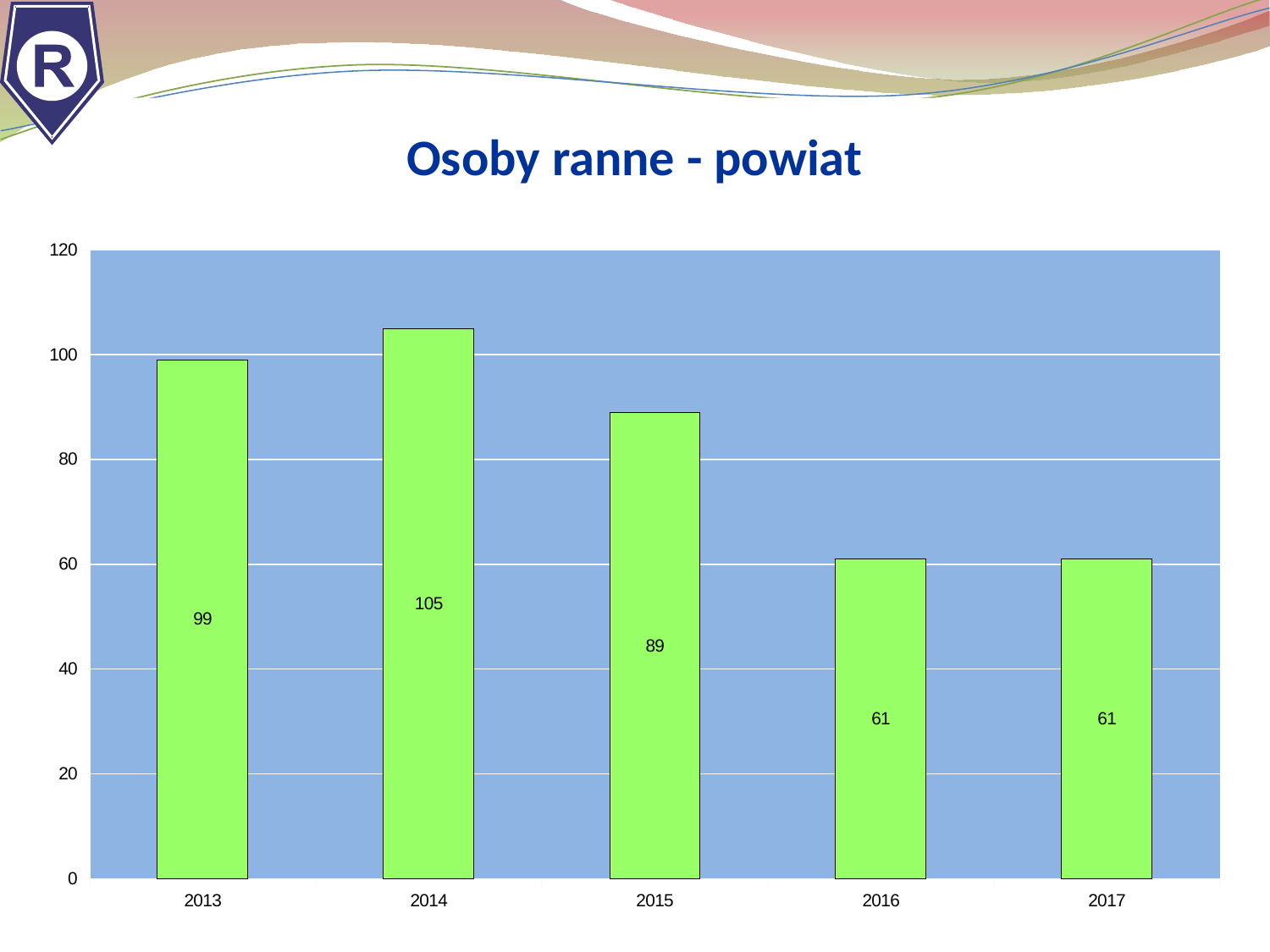
What is the value for 2017? 61 Is the value for 2014 greater or less than 100? greater Which is larger, the value for 2013 or the value for 2015? 2013 What is the value for 2015? 89 What is the difference between the values for 2014 and 2015? 16 What is the value for 2013? 99 Which year has the highest value? 2014 What is the difference between the values for 2013 and 2016? 38 Do the values generally rise or fall from 2014 to 2017? fall How many years are shown on the x axis? 5 What kind of chart is shown on the slide? bar chart What is the title of the slide? Osoby ranne - powiat